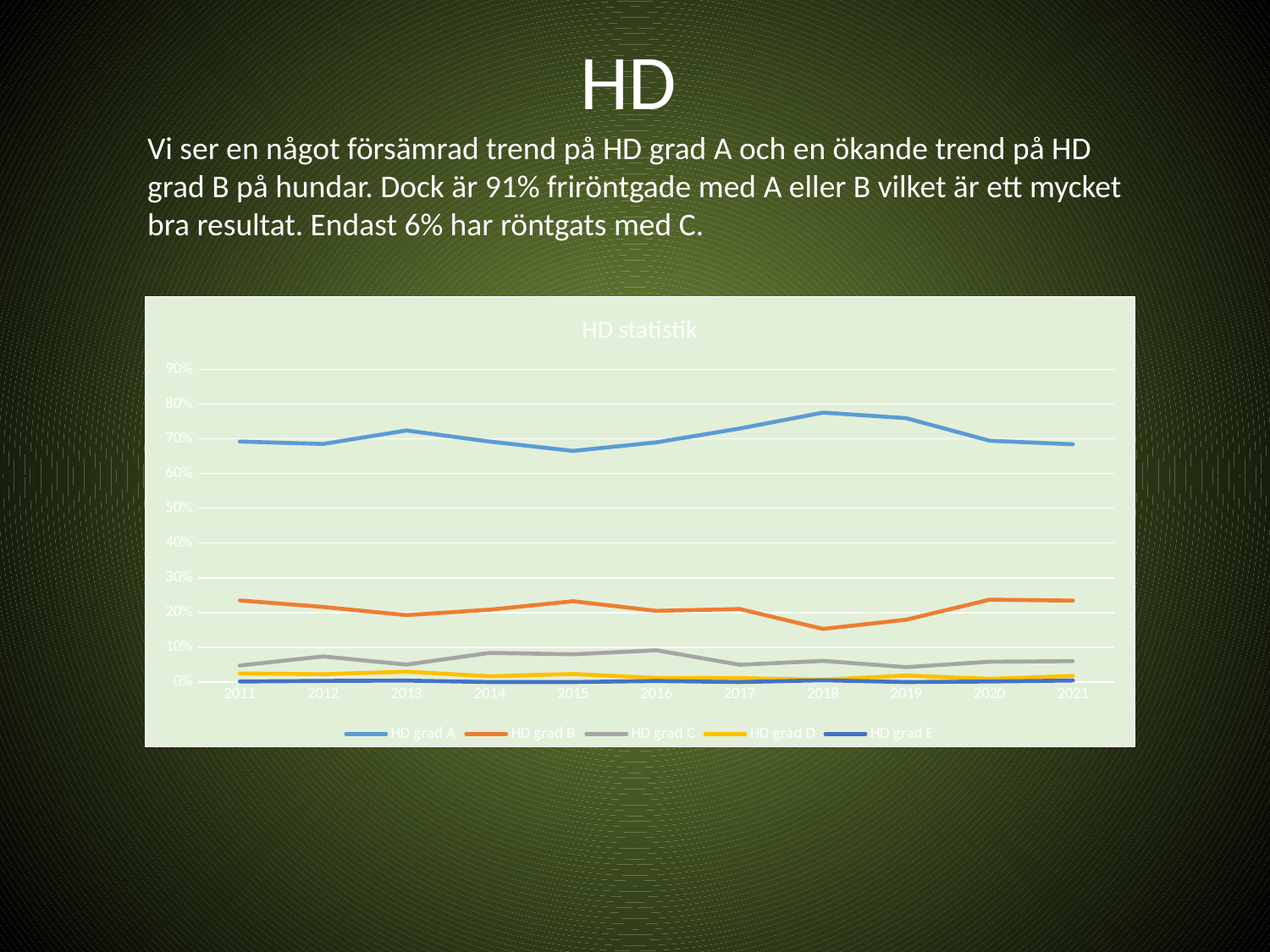
Is the value for HD grad B in 2018 greater or less than 20%? less In which year does HD grad B reach its lowest value? 2018 What kind of chart is shown on the slide? line chart Is the value for HD grad A in 2015 greater or less than 70%? less How many series does the legend of the HD statistik chart list? 5 How many years are shown on the x axis of the HD statistik chart? 11 In which year does HD grad A reach its highest value? 2018 In 2016, which is larger: HD grad C or HD grad D? HD grad C What is the title of the chart on the slide? HD statistik Is the value for HD grad A in 2018 greater or less than 70%? greater Which series has the highest values across all years in the HD statistik chart? HD grad A